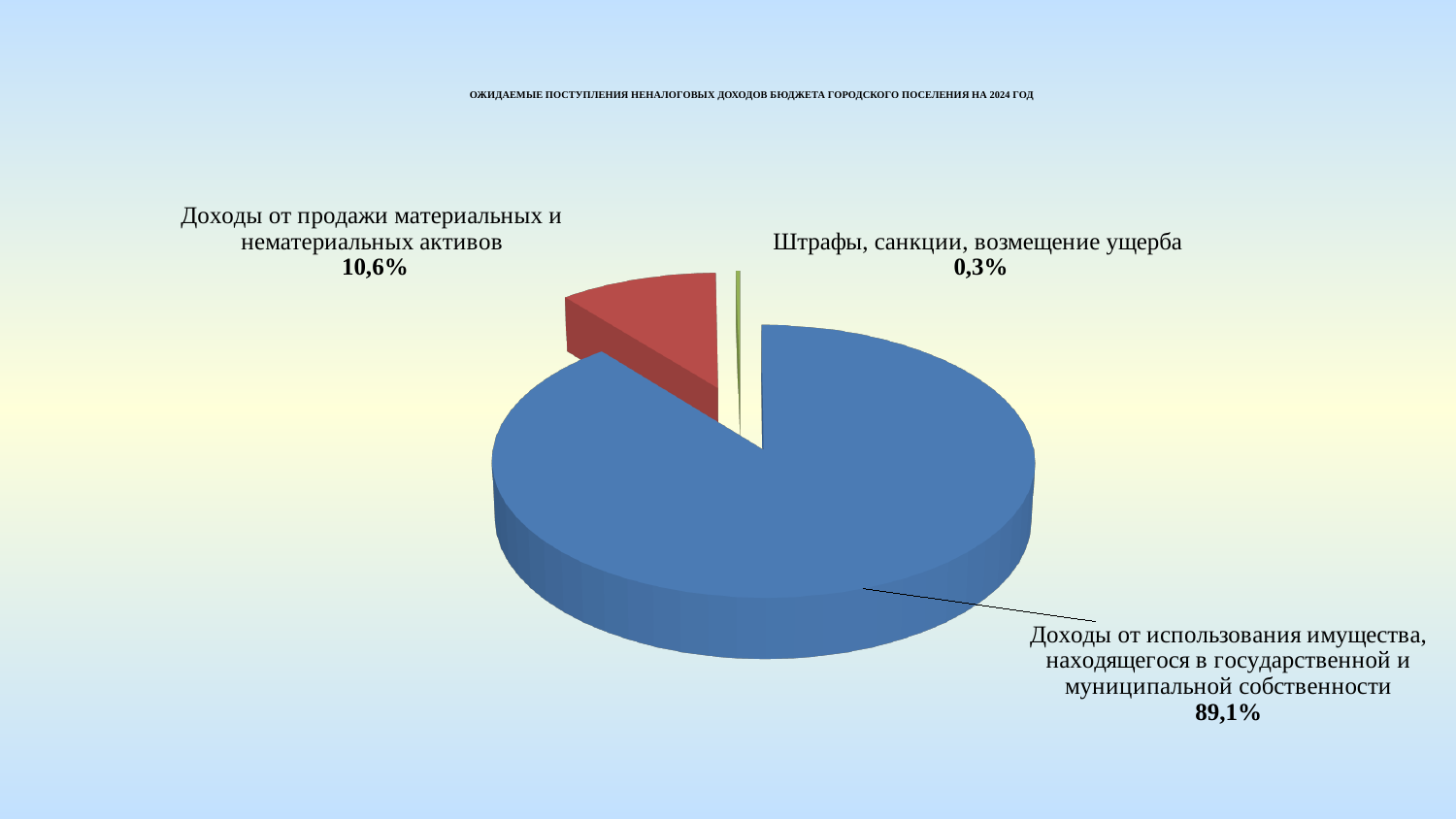
Which category has the largest slice of the pie? Доходы от использования имущества, находящегося в государственной и муниципальной собственности What is the title of the chart on the slide? ОЖИДАЕМЫЕ ПОСТУПЛЕНИЯ НЕНАЛОГОВЫХ ДОХОДОВ БЮДЖЕТА ГОРОДСКОГО ПОСЕЛЕНИЯ НА 2024 ГОД Which is larger: the share for "Доходы от продажи материальных и нематериальных активов" or the share for "Штрафы, санкции, возмещение ущерба"? Доходы от продажи материальных и нематериальных активов What share of the pie is labelled for "Доходы от продажи материальных и нематериальных активов"? 10,6% What share of the pie is labelled for "Доходы от использования имущества, находящегося в государственной и муниципальной собственности"? 89,1% What is the difference in percentage points between the largest slice and "Доходы от продажи материальных и нематериальных активов"? 78,5 Which category has the smallest slice of the pie? Штрафы, санкции, возмещение ущерба What colour is the slice for "Доходы от продажи материальных и нематериальных активов"? Red How many slices does the pie chart have? 3 What is the difference in percentage points between "Доходы от продажи материальных и нематериальных активов" and "Штрафы, санкции, возмещение ущерба"? 10,3 What share of the pie is labelled for "Штрафы, санкции, возмещение ущерба"? 0,3% What type of chart is shown on the slide? Pie chart